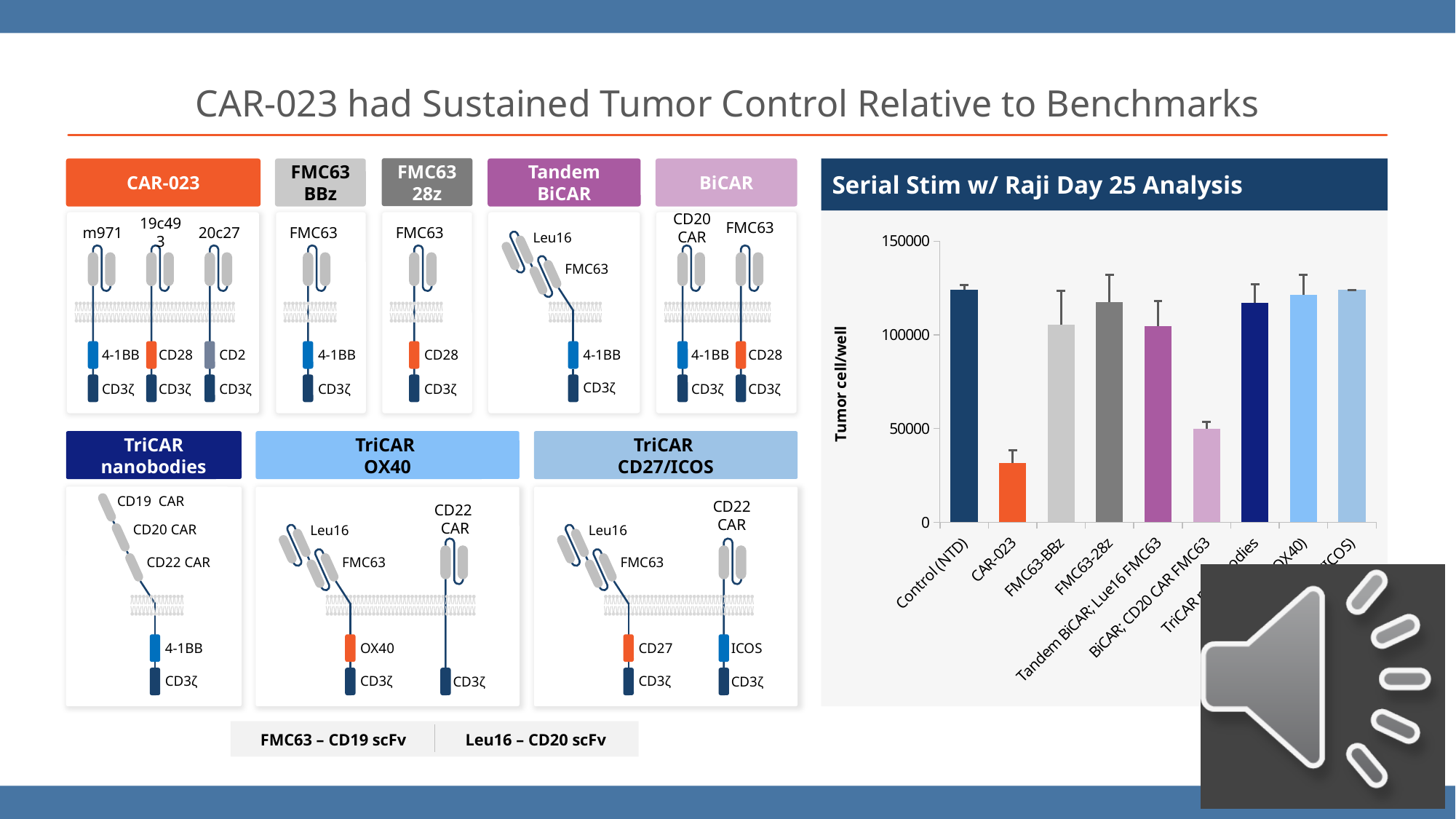
How many bars are plotted in the chart? 9 Is the value for Control (NTD) greater or less than 150000? less What is the title of the chart on the slide? Serial Stim w/ Raji Day 25 Analysis Which is larger, the value for BiCAR; CD20 CAR FMC63 or the value for Control (NTD)? Control (NTD) Which is larger, the value for CAR-023 or the value for BiCAR; CD20 CAR FMC63? BiCAR; CD20 CAR FMC63 Which is larger, the value for CAR-023 or the value for FMC63-28z? FMC63-28z Is the value for FMC63-28z greater or less than 100000? greater What kind of chart is shown on the slide? bar chart Is the value for CAR-023 greater or less than 50000? less What is the label of the y axis of the chart? Tumor cell/well Which category has the lowest value in the chart? CAR-023